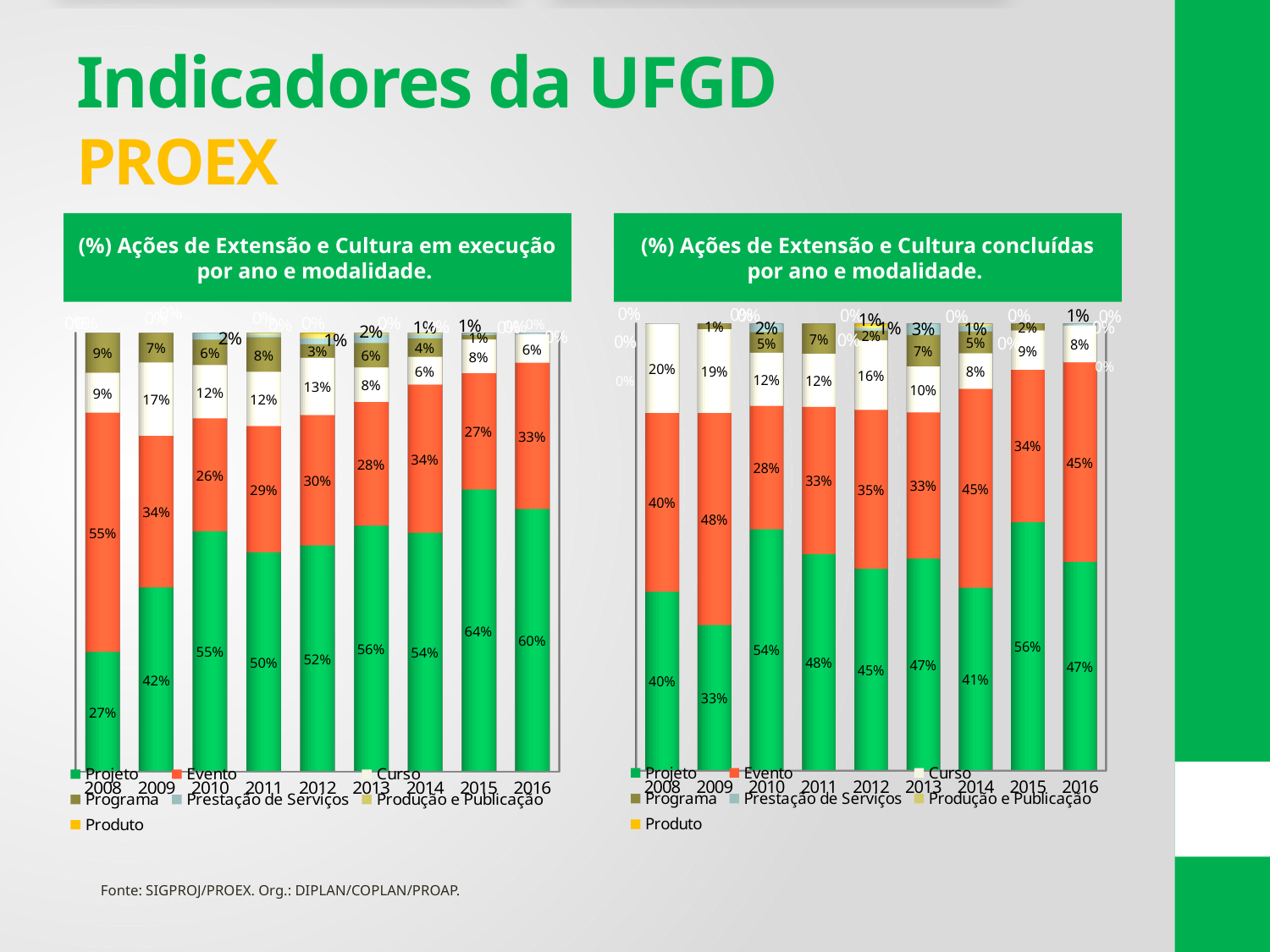
In the right chart, '(%) Ações de Extensão e Cultura concluídas por ano e modalidade', which year has the lowest Projeto value? 2009 In the right chart, '(%) Ações de Extensão e Cultura concluídas por ano e modalidade', what is the Curso value for 2008? 20% What kind of chart is the left chart, '(%) Ações de Extensão e Cultura em execução por ano e modalidade'? Stacked bar chart In the left chart, '(%) Ações de Extensão e Cultura em execução por ano e modalidade', which year has the lowest Projeto value? 2008 How many series does the legend of the right chart, '(%) Ações de Extensão e Cultura concluídas por ano e modalidade', list? 7 In the left chart, '(%) Ações de Extensão e Cultura em execução por ano e modalidade', which year has the highest Projeto value? 2015 In the right chart, '(%) Ações de Extensão e Cultura concluídas por ano e modalidade', what is the Projeto value for 2015? 56% In the left chart, '(%) Ações de Extensão e Cultura em execução por ano e modalidade', what is the difference between the Evento values for 2008 and 2009? 21% In the left chart, '(%) Ações de Extensão e Cultura em execução por ano e modalidade', what is the Projeto value for 2008? 27% In the right chart, '(%) Ações de Extensão e Cultura concluídas por ano e modalidade', which is larger in 2014: the Projeto value or the Evento value? Evento In the left chart, '(%) Ações de Extensão e Cultura em execução por ano e modalidade', what is the Evento value for 2016? 33% How many years are shown on the x axis of the left chart, '(%) Ações de Extensão e Cultura em execução por ano e modalidade'? 9